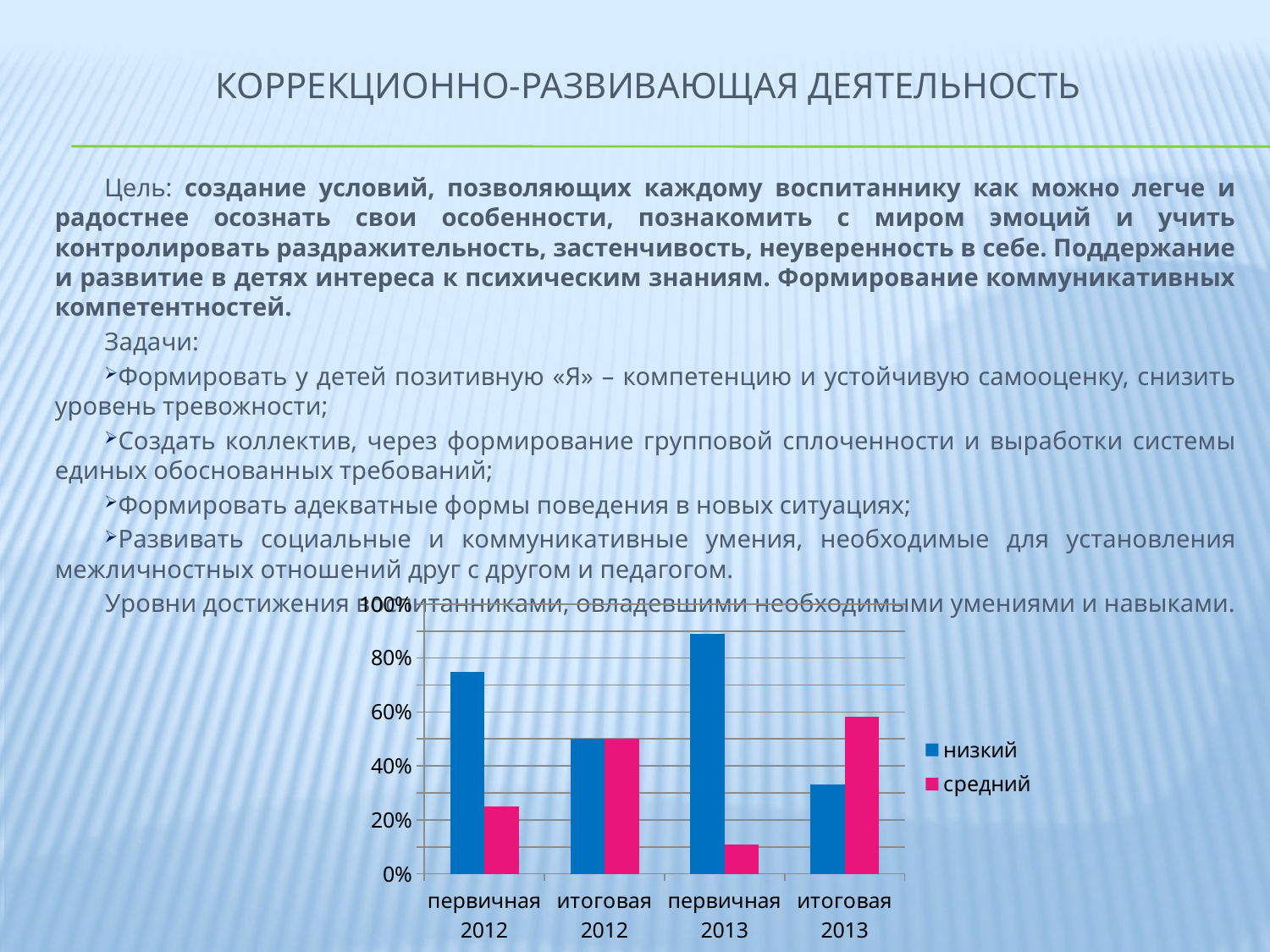
For the series низкий, which category has the highest bar? первичная 2013 Which series is shown in blue in the chart? низкий What kind of chart is shown on the slide? bar chart How many categories are shown on the x axis of the chart? 4 For the series средний, which category has the highest bar? итоговая 2013 Does the value for низкий rise or fall from первичная 2013 to итоговая 2013? fall For the series средний, which category has the lowest bar? первичная 2013 How many series does the chart legend list? 2 In первичная 2012, which series has the larger value, низкий or средний? низкий Is the value for средний in первичная 2013 greater or less than 20%? less Is the value for низкий in первичная 2012 greater or less than 60%? greater For the series низкий, which category has the lowest bar? итоговая 2013